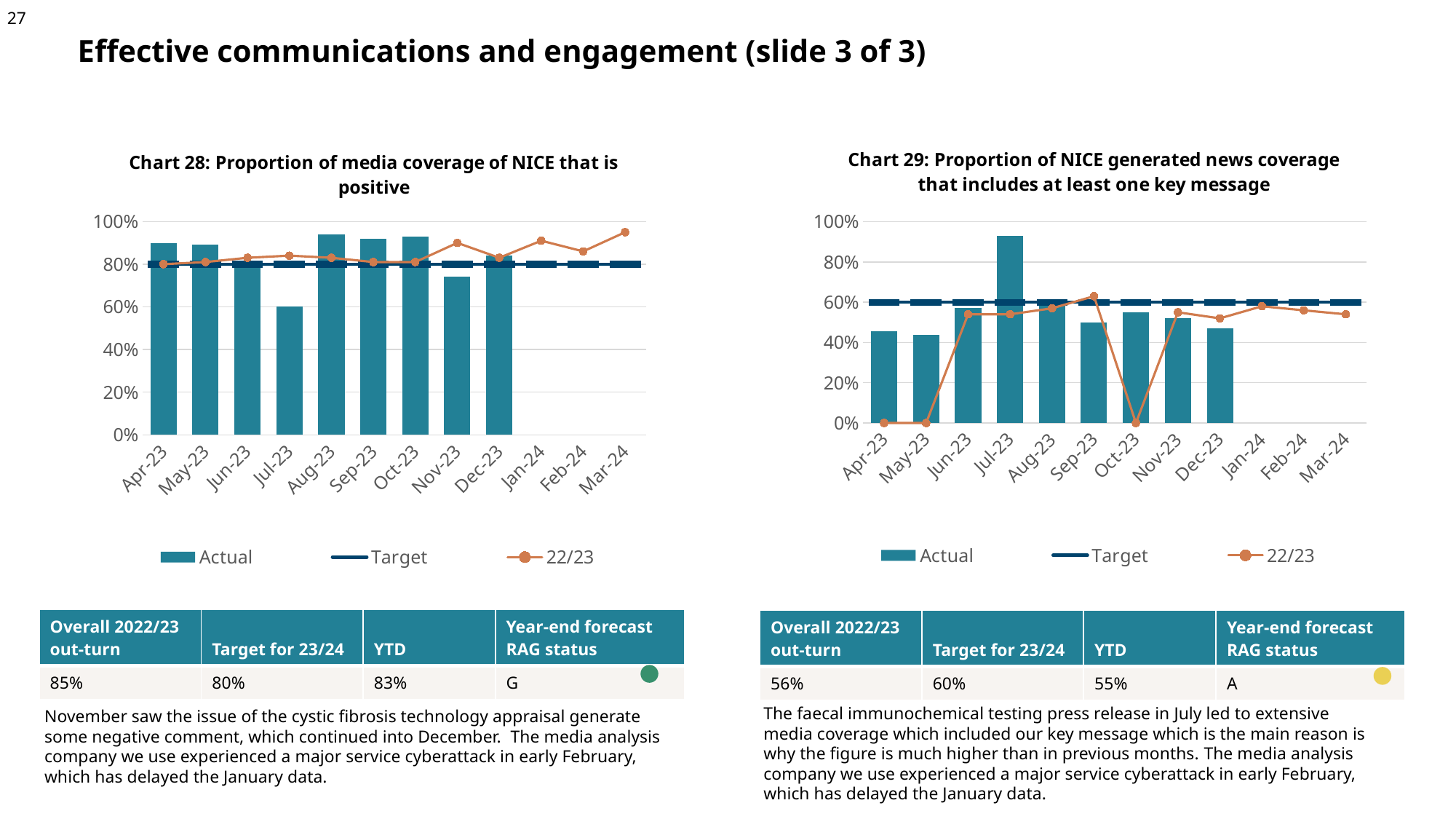
In Chart 28, which month has the lowest Actual bar? Jul-23 What kind of chart is Chart 29? Bar chart with line series In Chart 28, how many months have an Actual bar plotted? 9 In Chart 28, how many series does the legend list? 3 In Chart 28, is the Actual value for Apr-23 greater or less than 80%? greater In Chart 29, which month has the highest Actual bar? Jul-23 In Chart 29, is the Actual value for Jul-23 greater or less than 80%? greater In Chart 28, which is larger, the Actual value for Jul-23 or for Nov-23? Nov-23 In Chart 28, is the Actual value for Nov-23 greater or less than 80%? less In Chart 29, which is larger, the Actual value for Jul-23 or for Sep-23? Jul-23 In Chart 29, what is the 22/23 value for Oct-23? 0%